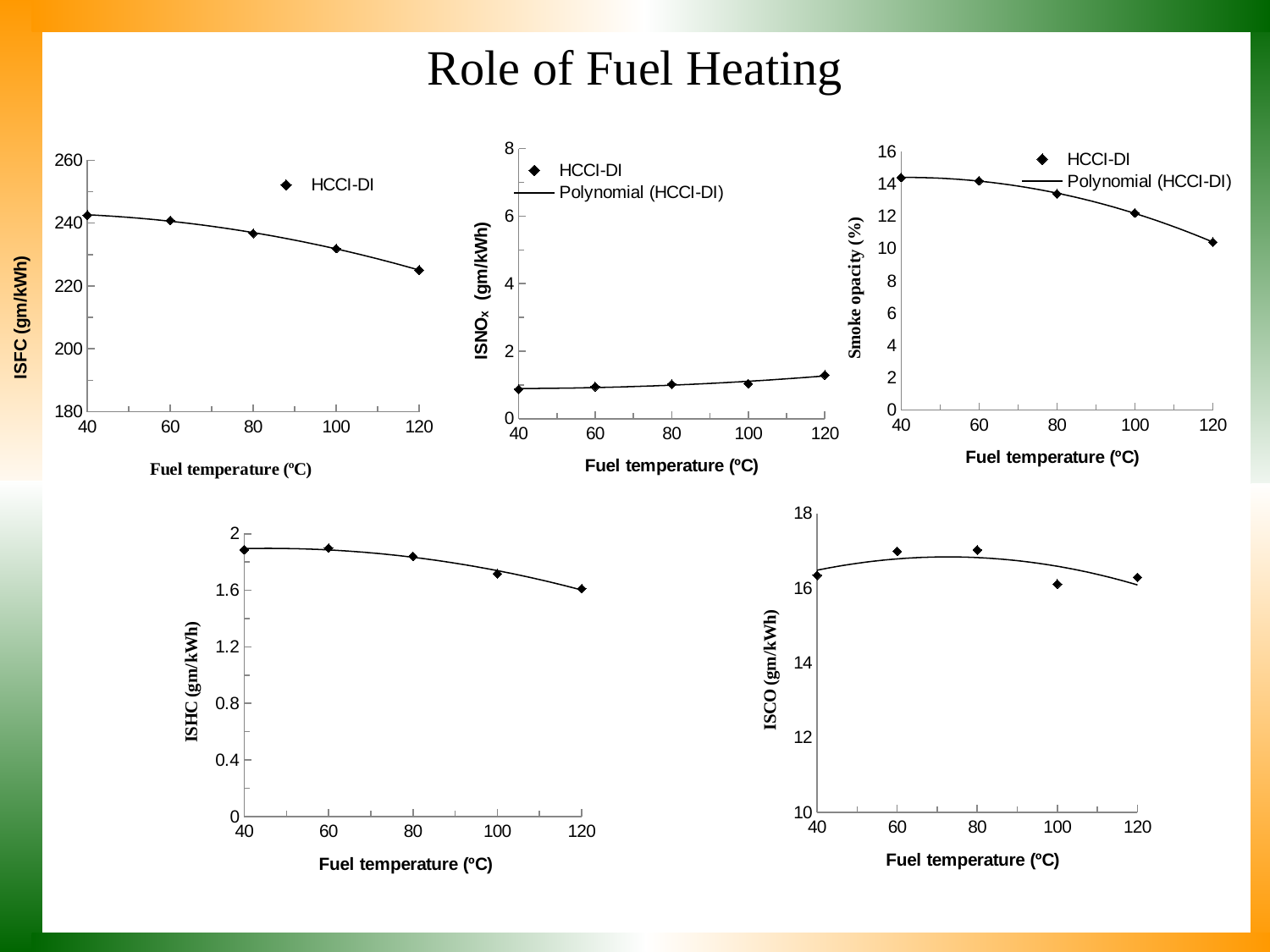
In the Smoke opacity chart (top right), do the values rise or fall as fuel temperature increases? fall In the ISFC chart (top left), do the values rise or fall as fuel temperature increases? fall How many entries does the legend of the ISNOx chart (top middle) list? 2 In the ISNOx chart (top middle), do the values rise or fall as fuel temperature increases? rise In the Smoke opacity chart (top right), is the value at 120 °C greater or less than 12? less In the ISNOx chart (top middle), is the value at 120 °C greater or less than 2? less In the ISFC chart (top left), is the value at 120 °C greater or less than 240? less How many charts are shown on the slide? 5 What is the x-axis label shared by all the charts on the slide? Fuel temperature (°C) In the ISFC chart (top left), how many data points are plotted? 5